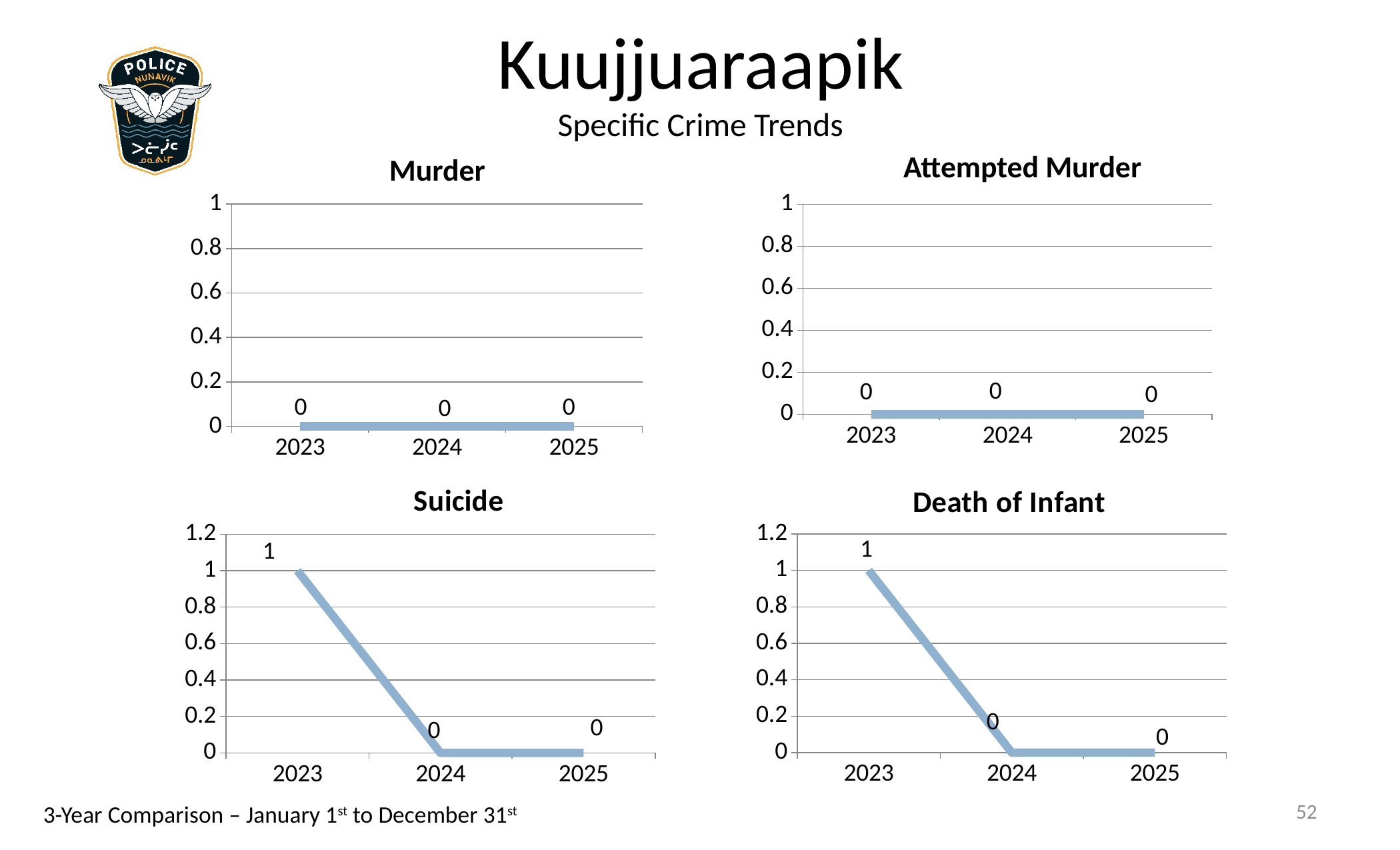
In the Murder chart, what is the value for 2024? 0 What kind of chart is the Suicide chart? line chart How many charts are shown on the slide? 4 In the Suicide chart, which year has the highest value? 2023 In the Attempted Murder chart, what is the value for 2025? 0 In the Suicide chart, what is the value for 2023? 1 In the Suicide chart, which is larger, the value for 2023 or the value for 2025? 2023 In the Death of Infant chart, what is the value for 2025? 0 What is the title of the chart in the top right of the slide? Attempted Murder In the Death of Infant chart, what is the difference between the 2023 and 2024 values? 1 How many years are plotted on the x axis of the Murder chart? 3 In the Death of Infant chart, do the values rise or fall from 2023 to 2025? fall